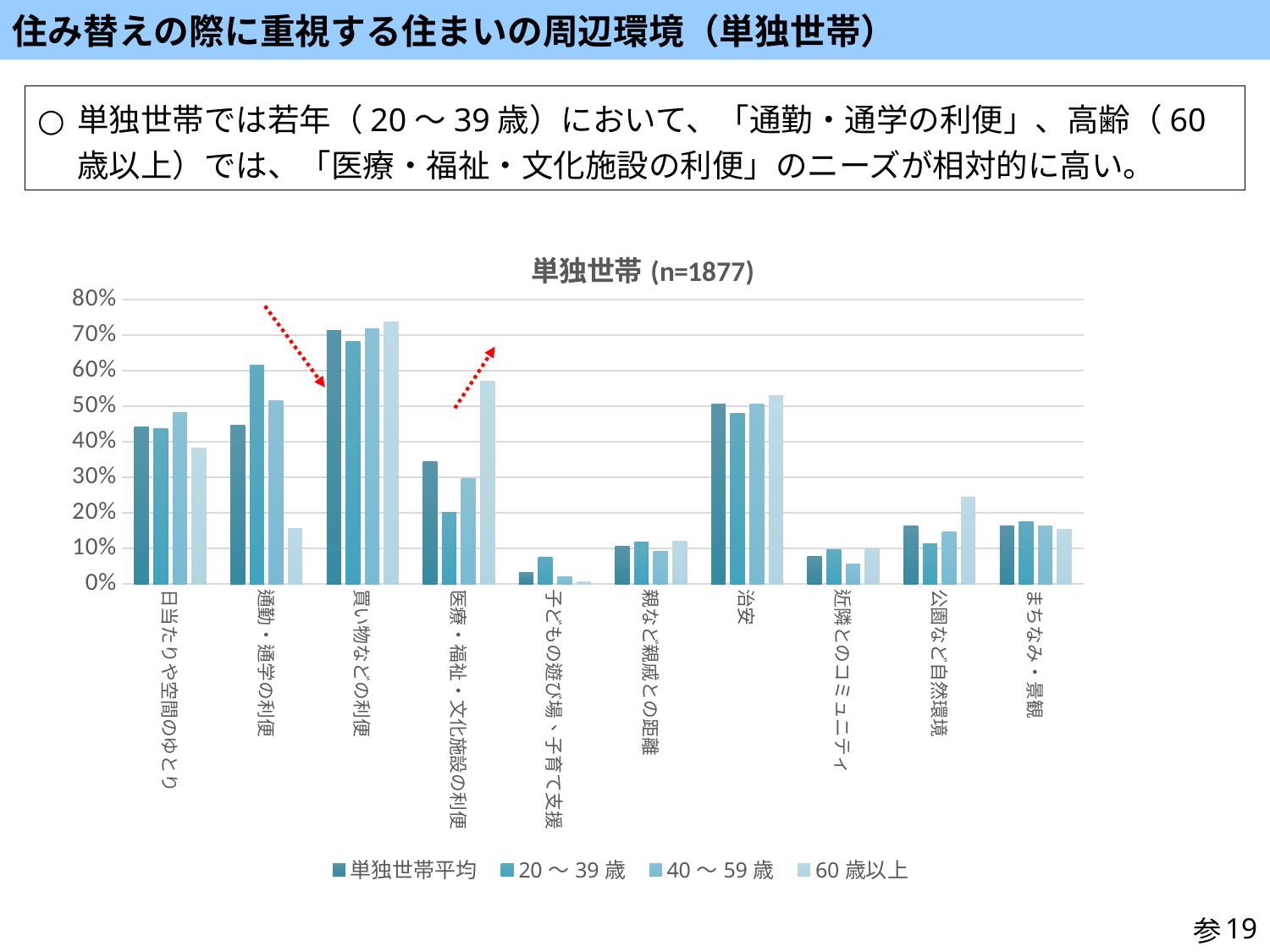
Is the value for 通勤・通学の利便 in the 20～39歳 series greater or less than 50%? greater Which category has the lowest value for the 60歳以上 series? 子どもの遊び場・子育て支援 Is the value for 医療・福祉・文化施設の利便 in the 60歳以上 series greater or less than 50%? greater Is the value for 通勤・通学の利便 in the 60歳以上 series greater or less than 20%? less How many categories are shown along the x axis of the chart? 10 What kind of chart is shown on the slide? bar chart What is the title of the chart? 単独世帯 (n=1877) Which category has the highest value for the 60歳以上 series? 買い物などの利便 For 医療・福祉・文化施設の利便, which series has the larger value: 20～39歳 or 60歳以上? 60歳以上 How many series does the legend of the chart list? 4 For 通勤・通学の利便, which series has the larger value: 20～39歳 or 60歳以上? 20～39歳